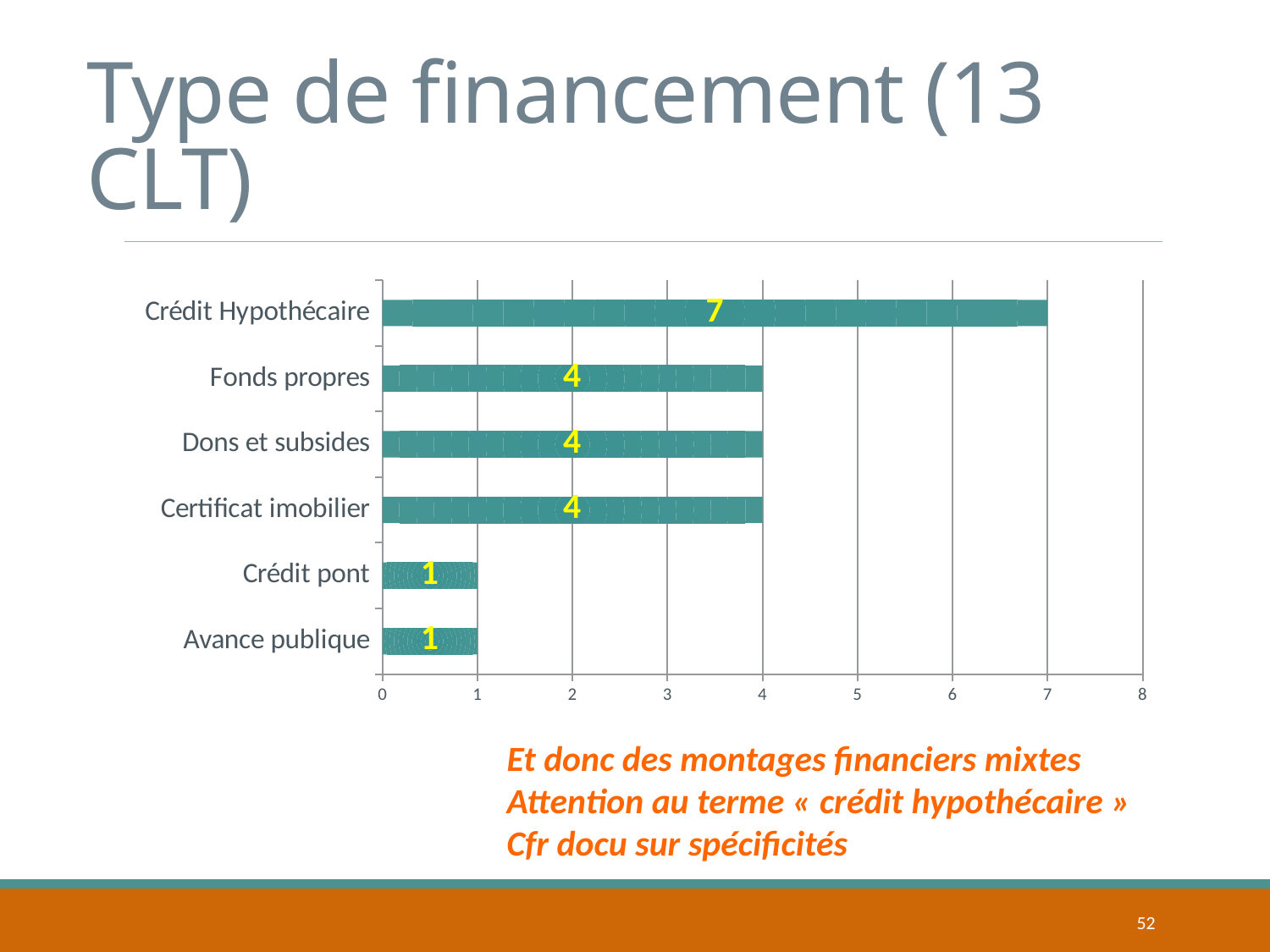
Which is larger, the value for Dons et subsides or the value for Crédit pont? Dons et subsides What is the value for Certificat imobilier? 4 Which category has the highest value? Crédit Hypothécaire What is the title of the slide containing the chart? Type de financement (13 CLT) How many categories are shown in the chart? 6 What is the value for Fonds propres? 4 What kind of chart is shown on the slide? bar chart What is the difference between the values for Fonds propres and Crédit pont? 3 What is the difference between the values for Crédit Hypothécaire and Dons et subsides? 3 What is the value for Avance publique? 1 What is the value for Crédit Hypothécaire? 7 Is the value for Crédit Hypothécaire greater or less than 5? greater